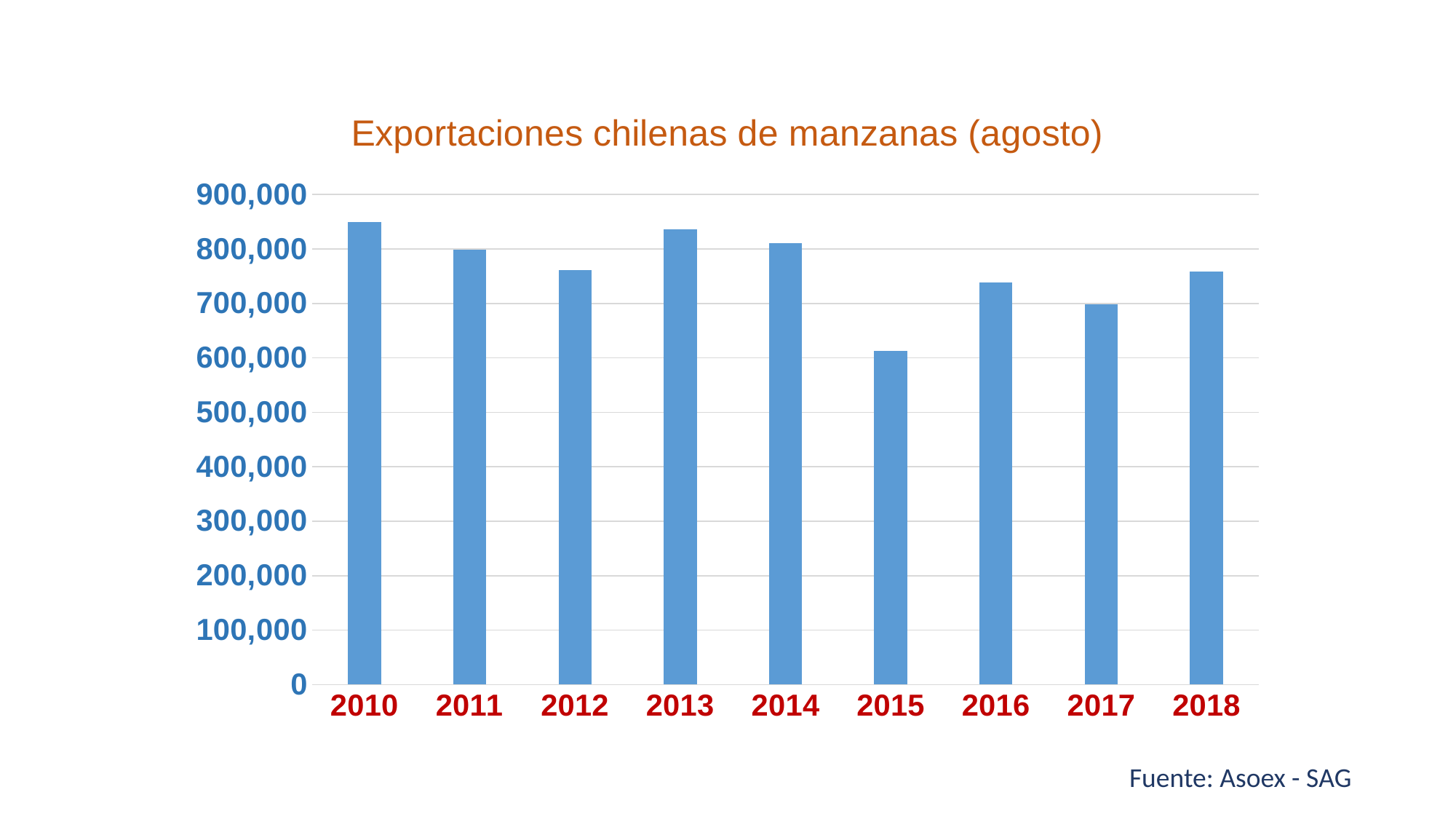
Which is larger, the value for 2013 or the value for 2017? 2013 Which year has the highest value in the chart? 2010 Is the value for 2018 greater or less than 800,000? less Is the value for 2015 greater or less than 700,000? less Is the value for 2010 greater or less than 800,000? greater Which is larger, the value for 2011 or the value for 2016? 2011 How many years are shown on the x axis of the chart? 9 What is the title of the chart? Exportaciones chilenas de manzanas (agosto) What kind of chart is shown on the slide? bar chart Which year has the lowest value in the chart? 2015